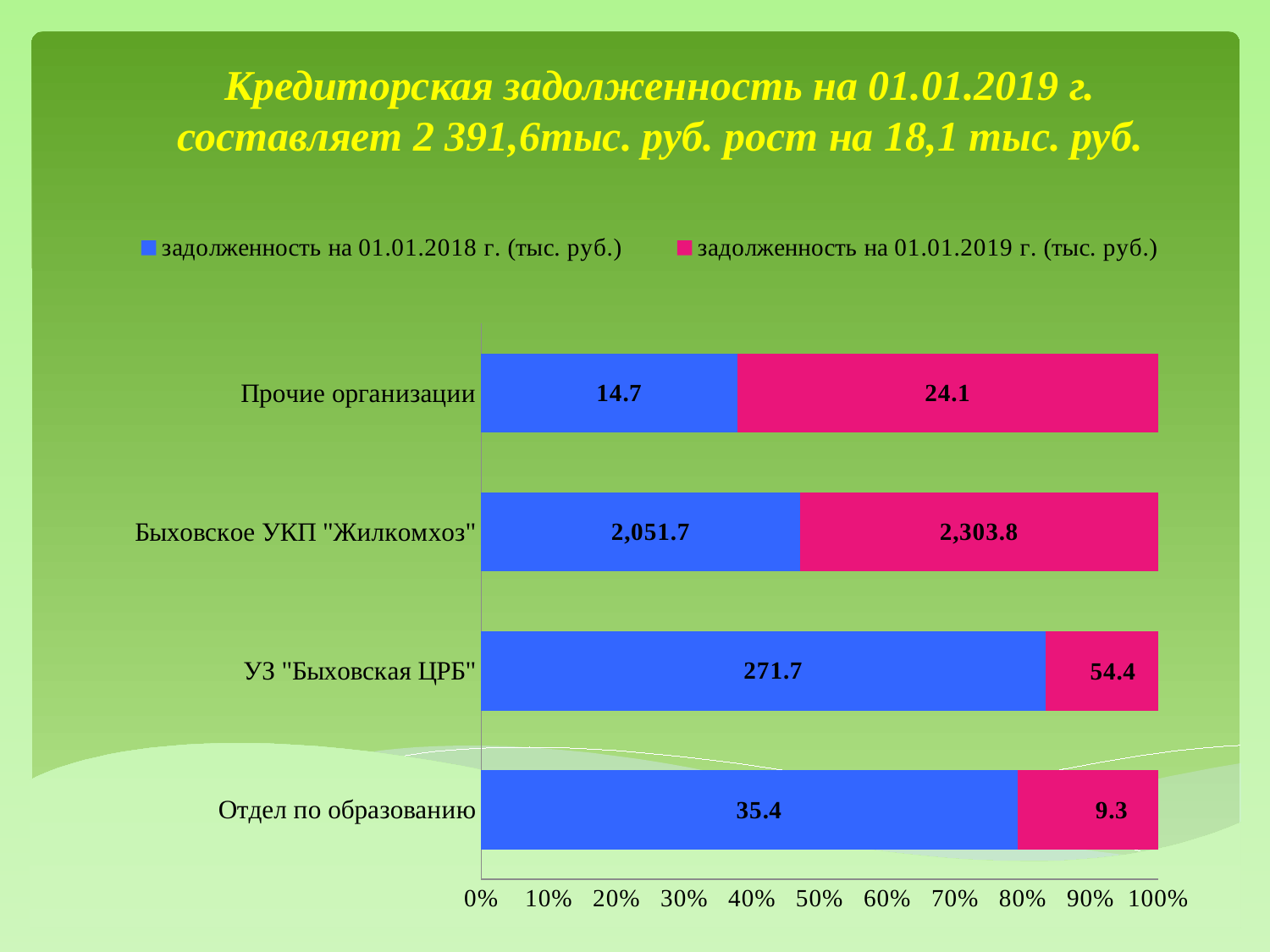
What is the value of задолженность на 01.01.2018 г. (тыс. руб.) for Прочие организации? 14.7 What is the value of задолженность на 01.01.2019 г. (тыс. руб.) for Быховское УКП "Жилкомхоз"? 2,303.8 How many categories are shown on the chart? 4 What kind of chart is shown on the slide? Stacked bar chart What is the value of задолженность на 01.01.2018 г. (тыс. руб.) for УЗ "Быховская ЦРБ"? 271.7 What is the difference between the 01.01.2019 and 01.01.2018 values for Быховское УКП "Жилкомхоз"? 252.1 Which category has the lowest value for задолженность на 01.01.2018 г. (тыс. руб.)? Прочие организации For УЗ "Быховская ЦРБ", which is larger: the value for 01.01.2018 or for 01.01.2019? 01.01.2018 Which category has the highest value for задолженность на 01.01.2019 г. (тыс. руб.)? Быховское УКП "Жилкомхоз" What colour represents задолженность на 01.01.2019 г. (тыс. руб.) in the chart? Pink (magenta) How many series does the legend list? 2 What is the value of задолженность на 01.01.2019 г. (тыс. руб.) for Отдел по образованию? 9.3